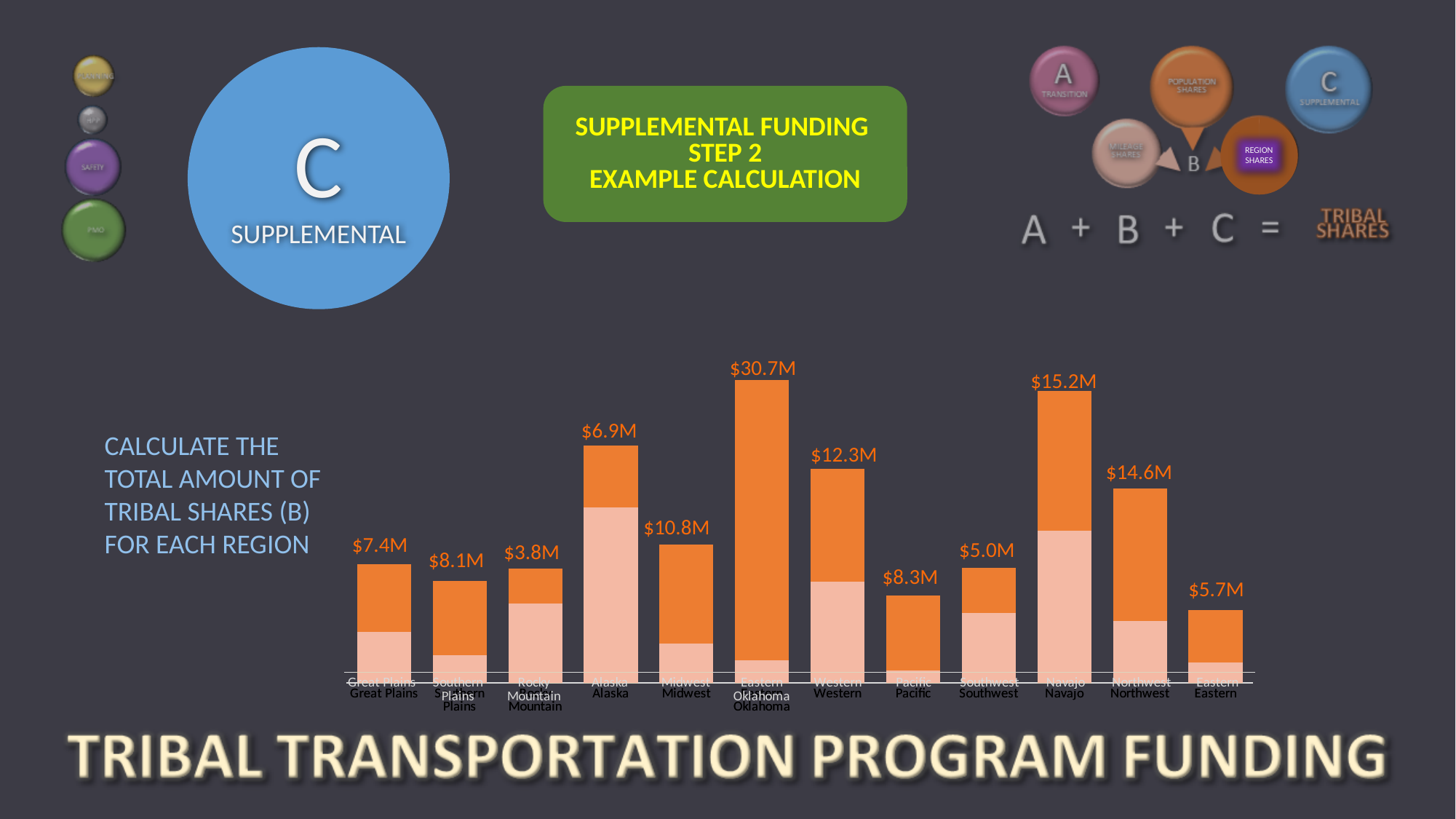
What is the value shown for Midwest? $10.8M What is the value shown for Rocky Mountain? $3.8M What is the value shown for Navajo? $15.2M Which region has the lowest value? Rocky Mountain What is the value shown for Eastern Oklahoma? $30.7M What is the difference between the values for Eastern Oklahoma and Western? $18.4M Which region has the highest value? Eastern Oklahoma What is the value shown for Southwest? $5.0M Which is larger, the value for Pacific or the value for Southern Plains? Pacific What kind of chart is shown on the slide? Stacked bar chart How many regions are shown in the chart? 12 What is the difference between the values for Navajo and Northwest? $0.6M